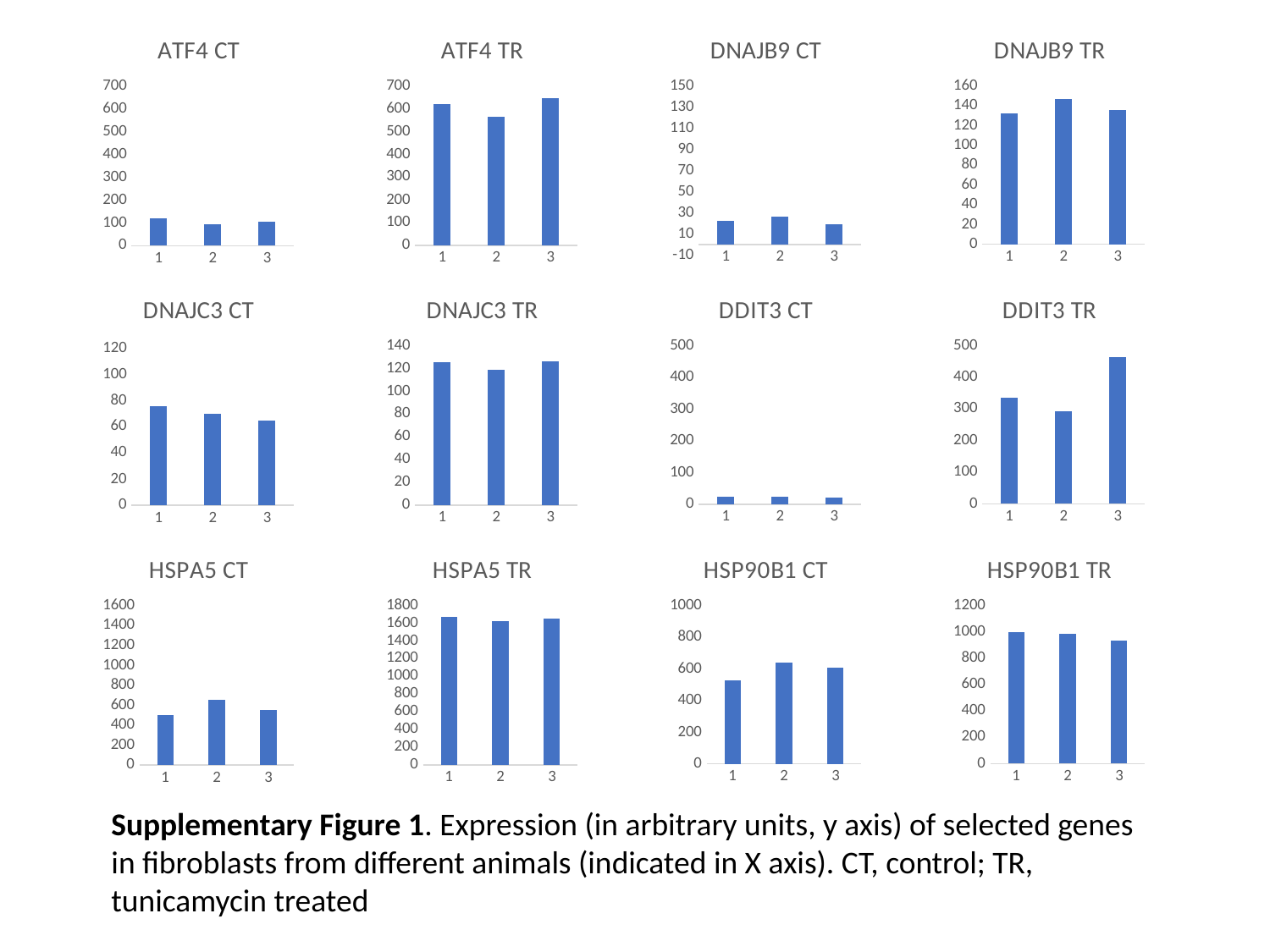
In the DDIT3 TR chart, which animal has the highest expression value? 3 What kind of chart is the HSPA5 TR chart? bar chart In the DDIT3 CT chart, is the value for animal 1 greater or less than 100? less In the DNAJB9 TR chart, is the value for animal 2 greater or less than 140? greater In the DNAJC3 TR chart, which animal has the lowest expression value? 2 In the ATF4 TR chart, is the value for animal 2 greater or less than 600? less In the HSPA5 CT chart, which animal has the lowest expression value? 1 In the HSP90B1 CT chart, which is larger, the value for animal 1 or the value for animal 2? animal 2 How many animals (categories) are shown on the x axis of the ATF4 CT chart? 3 How many separate charts are shown on the slide? 12 In the DNAJC3 CT chart, do the values rise or fall from animal 1 to animal 3? fall